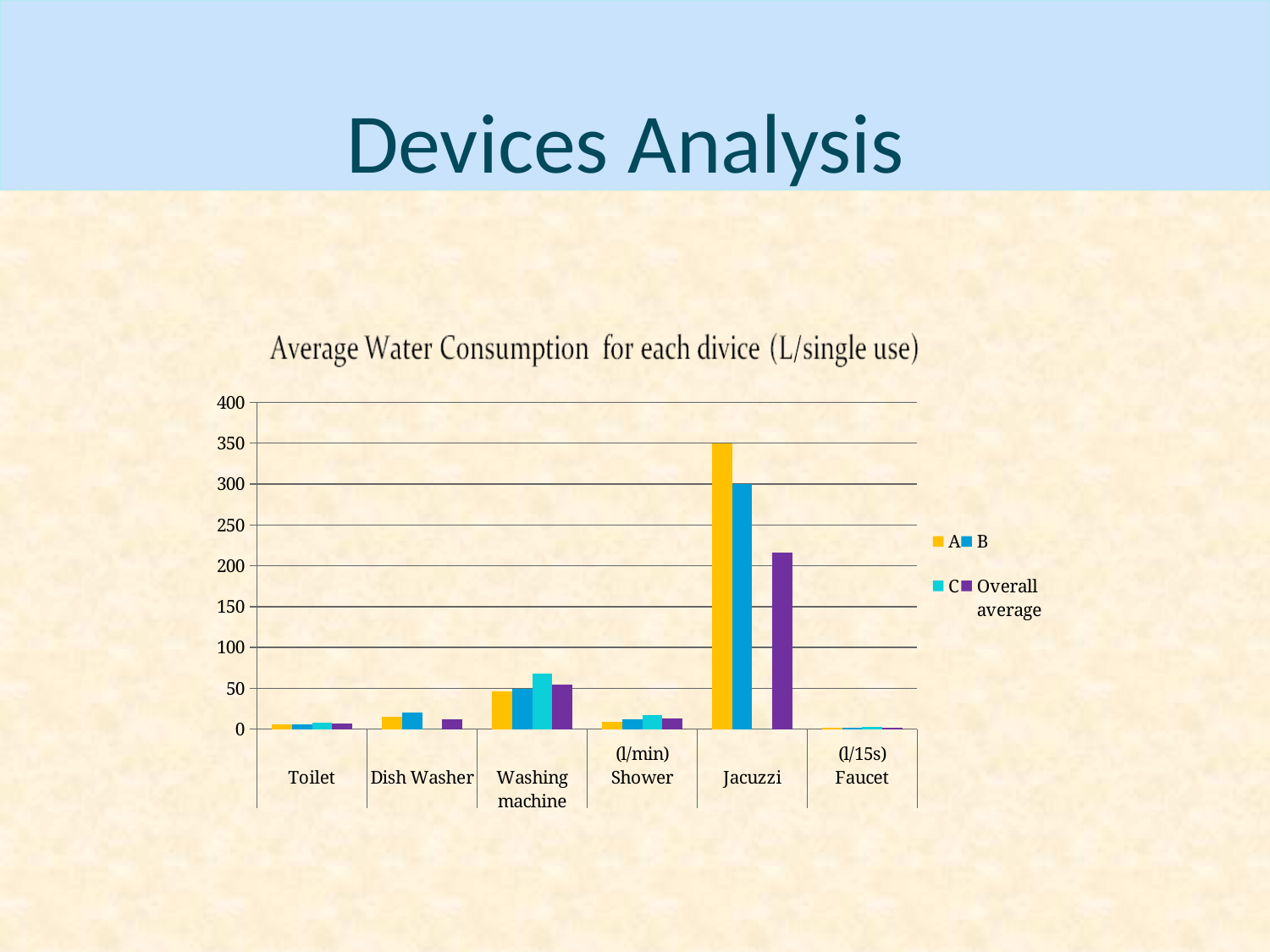
How many series does the legend list? 4 What kind of chart is shown on the slide? bar chart Is the value for series C for Washing machine greater or less than 50? greater Is the value for series A for Jacuzzi greater or less than 300? greater Which device has the highest value for series A? Jacuzzi Which is larger: the series A value for Washing machine or the series A value for Toilet? Washing machine How many device categories are shown on the x axis? 6 Is the Overall average value for Jacuzzi greater or less than 200? greater For Jacuzzi, which is larger: the value for series A or series B? A Which device has the lowest Overall average value? Faucet What is the title of the chart? Average Water Consumption for each divice (L/single use)